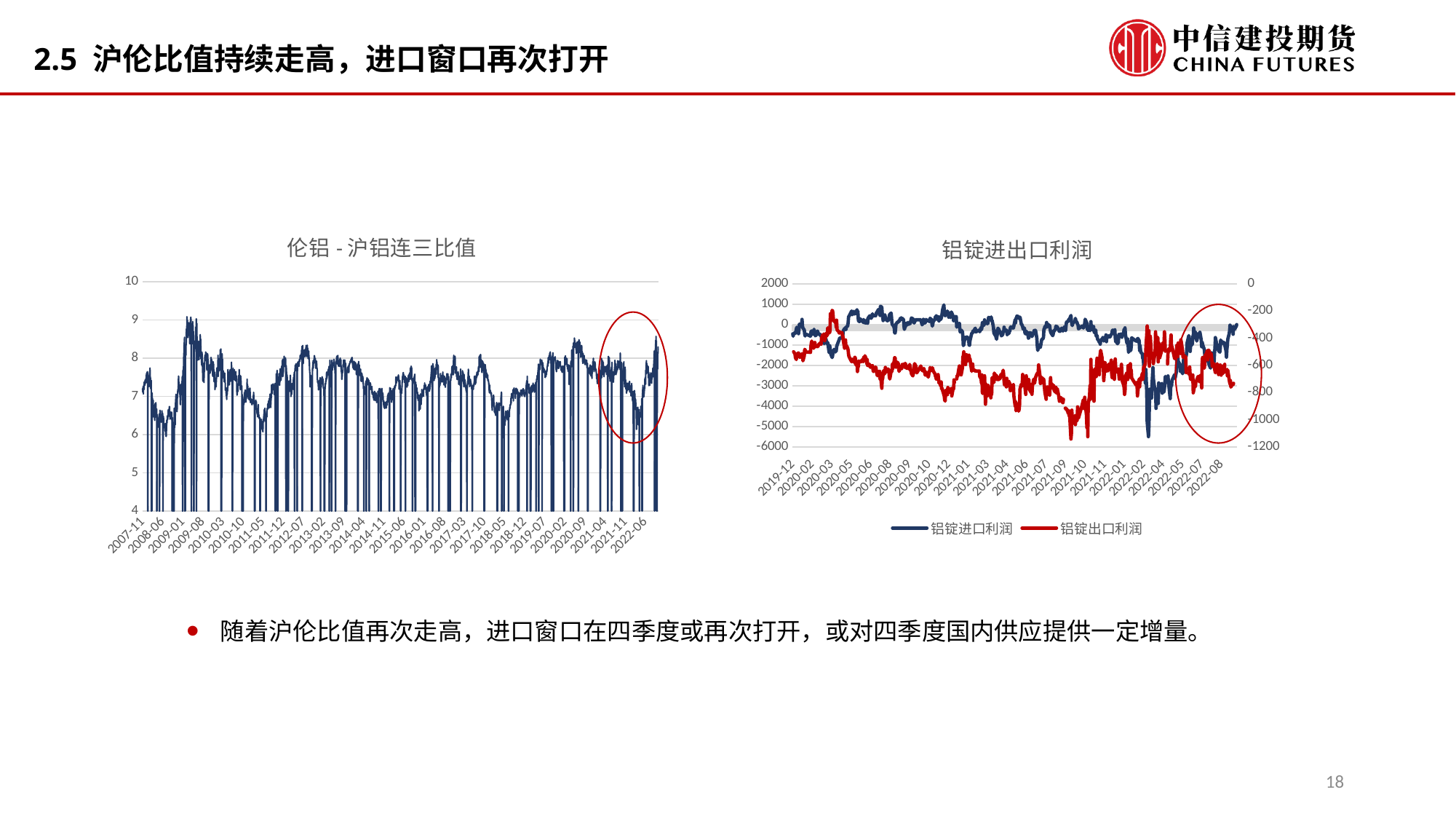
How many charts are shown on the slide? 2 How many series are plotted in the left chart (伦铝 - 沪铝连三比值)? 1 What kind of chart is the left chart titled 伦铝 - 沪铝连三比值? line chart How many series does the legend of the right chart (铝锭进出口利润) list? 2 What kind of chart is the right chart titled 铝锭进出口利润? line chart In the left chart (伦铝 - 沪铝连三比值), is the highest value reached in the whole series greater or less than 5? greater In the left chart (伦铝 - 沪铝连三比值), is the peak value reached at the far right end of the series (2022) greater or less than 8? greater In the right chart (铝锭进出口利润), what colour is the 铝锭出口利润 line? red In the right chart (铝锭进出口利润), is the lowest point of the blue 铝锭进口利润 line, read on the left axis, greater or less than -4000? less In the right chart (铝锭进出口利润), what are the two legend entries? 铝锭进口利润, 铝锭出口利润